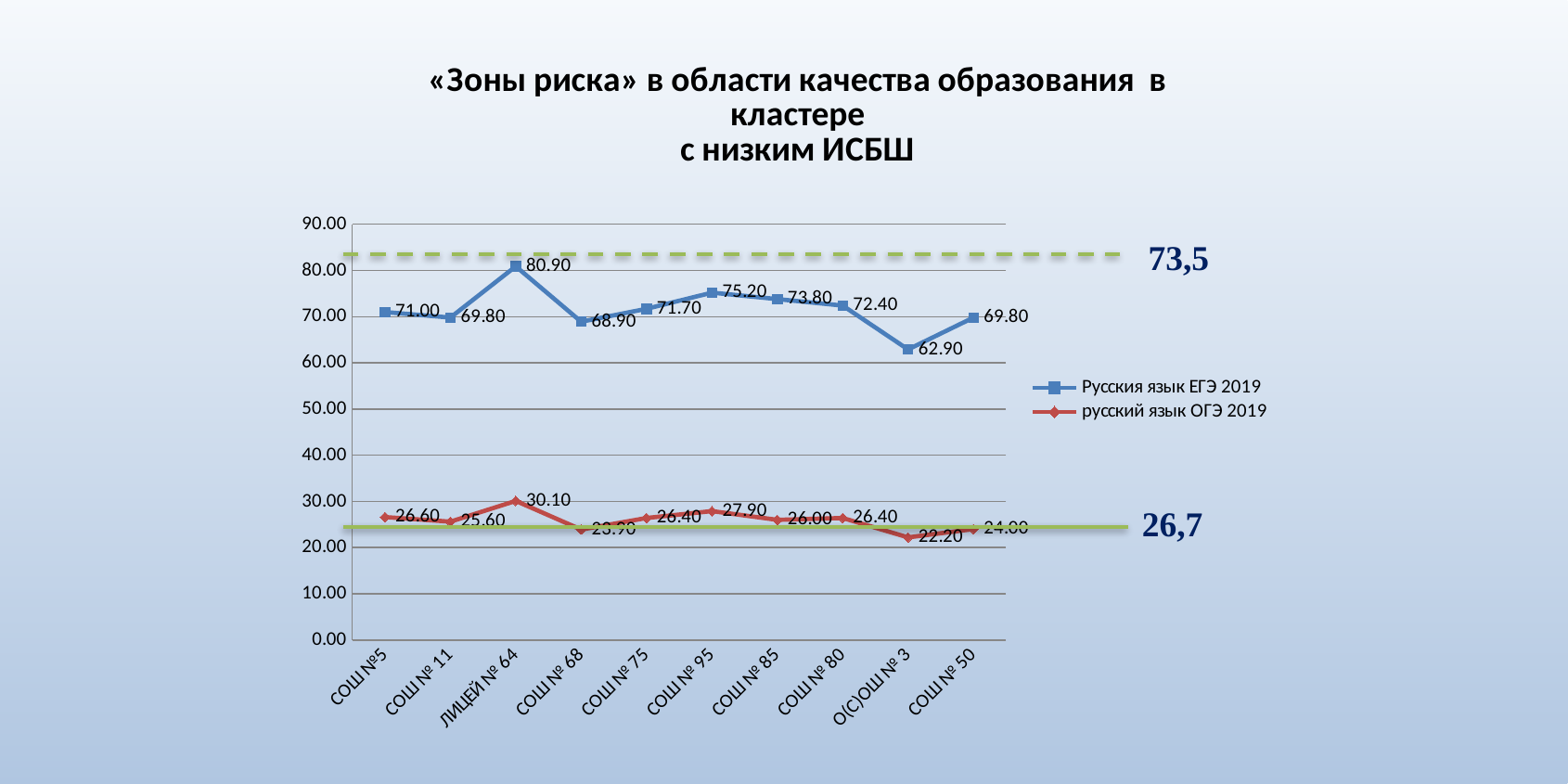
In the Русския язык ЕГЭ 2019 series, which is larger: СОШ № 95 or СОШ № 85? СОШ № 95 Which school has the lowest value in the русский язык ОГЭ 2019 series? О(С)ОШ № 3 Which school has the highest value in the Русския язык ЕГЭ 2019 series? ЛИЦЕЙ № 64 What is the value for СОШ № 95 in the русский язык ОГЭ 2019 series? 27.90 What is the difference between the Русския язык ЕГЭ 2019 values for ЛИЦЕЙ № 64 and О(С)ОШ № 3? 18.00 Which school has the highest value in the русский язык ОГЭ 2019 series? ЛИЦЕЙ № 64 How many schools are plotted along the x axis? 10 What kind of chart is shown on the slide? line chart What is the value for ЛИЦЕЙ № 64 in the Русския язык ЕГЭ 2019 series? 80.90 How many series does the legend list? 2 What value is labelled next to the dashed green reference line? 73,5 Which school has the lowest value in the Русския язык ЕГЭ 2019 series? О(С)ОШ № 3